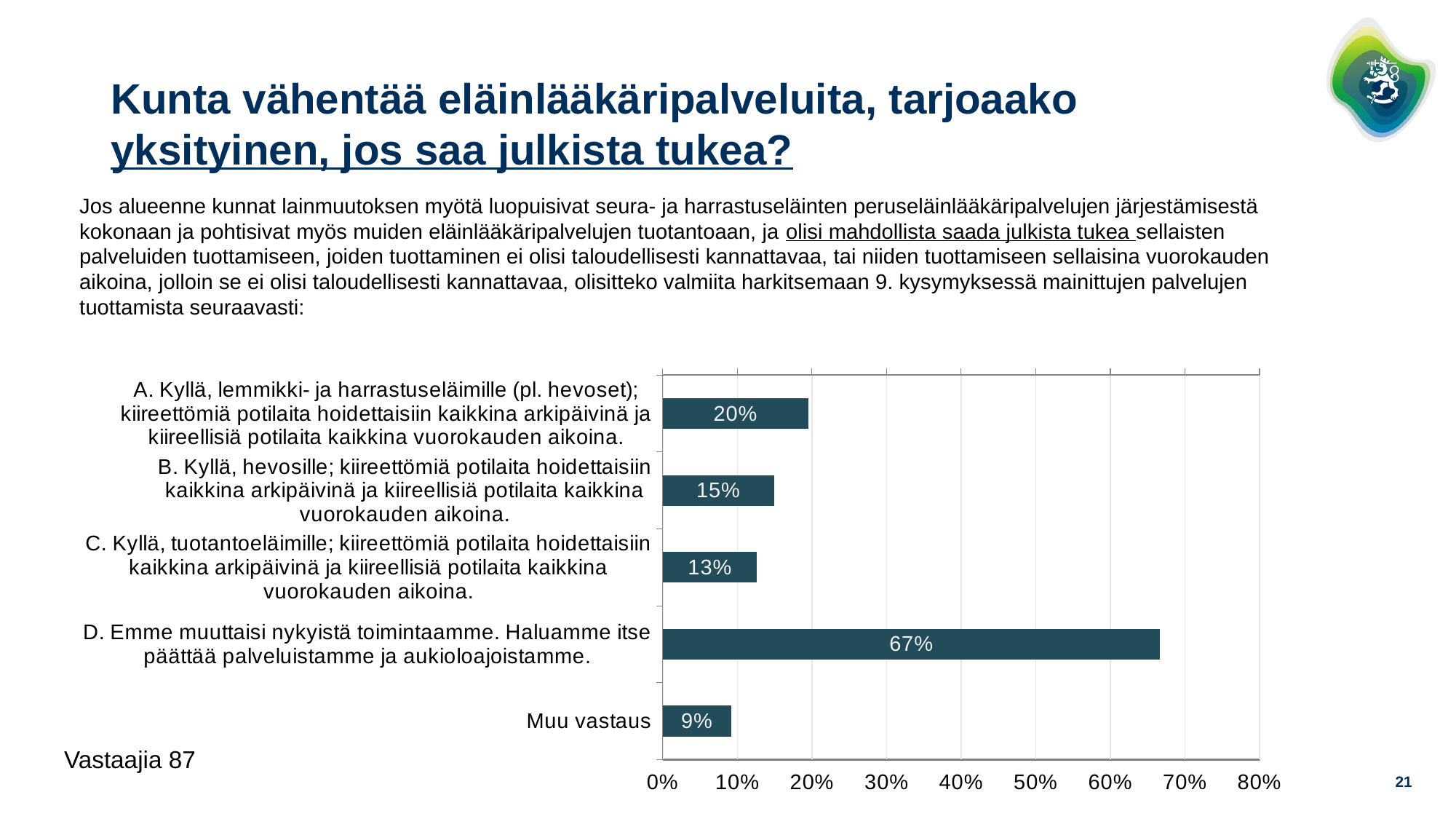
Which category has the lowest value? Muu vastaus What is the difference between the values for option D and option A? 47% What is the value for option D (Emme muuttaisi nykyistä toimintaamme)? 67% What is the maximum value shown on the x axis? 80% What kind of chart is shown on the slide? bar chart What is the value for 'Muu vastaus'? 9% What is the value for option A (Kyllä, lemmikki- ja harrastuseläimille)? 20% Is the value for option C greater or less than 20%? less Which is larger, the value for option B or option C? B. Kyllä, hevosille Which category has the highest value? D. Emme muuttaisi nykyistä toimintaamme. Haluamme itse päättää palveluistamme ja aukioloajoistamme. How many categories are shown in the chart? 5 What is the value for option B (Kyllä, hevosille)? 15%